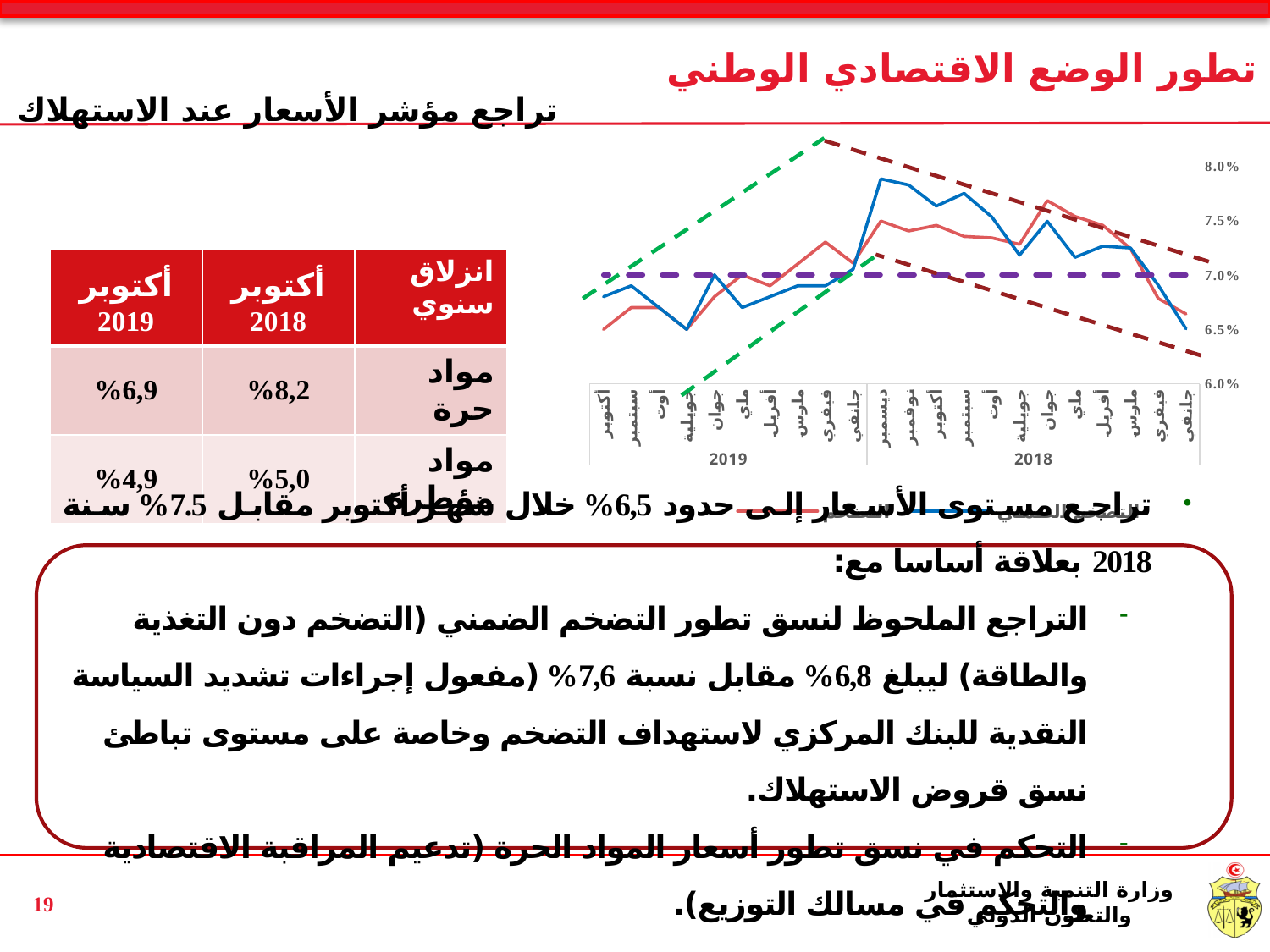
What is the range of the y axis on the chart? 6.0% to 8.0% Is the value of the blue line for October 2019 (the last point) greater or less than 7.0%? less Is the value of the red line for January 2018 (the first point) greater or less than 7.0%? less How many lines (series) are plotted on the chart? 3 Which two years are labelled on the x axis of the chart? 2018 and 2019 Is the highest value of the blue line greater or less than 7.5%? greater What kind of chart is shown on the slide? line chart At the peak in 2018, which line is higher, the blue line or the red line? the blue line In which year does the blue line reach its peak? 2018 Do the plotted values rise or fall over the course of 2019? fall